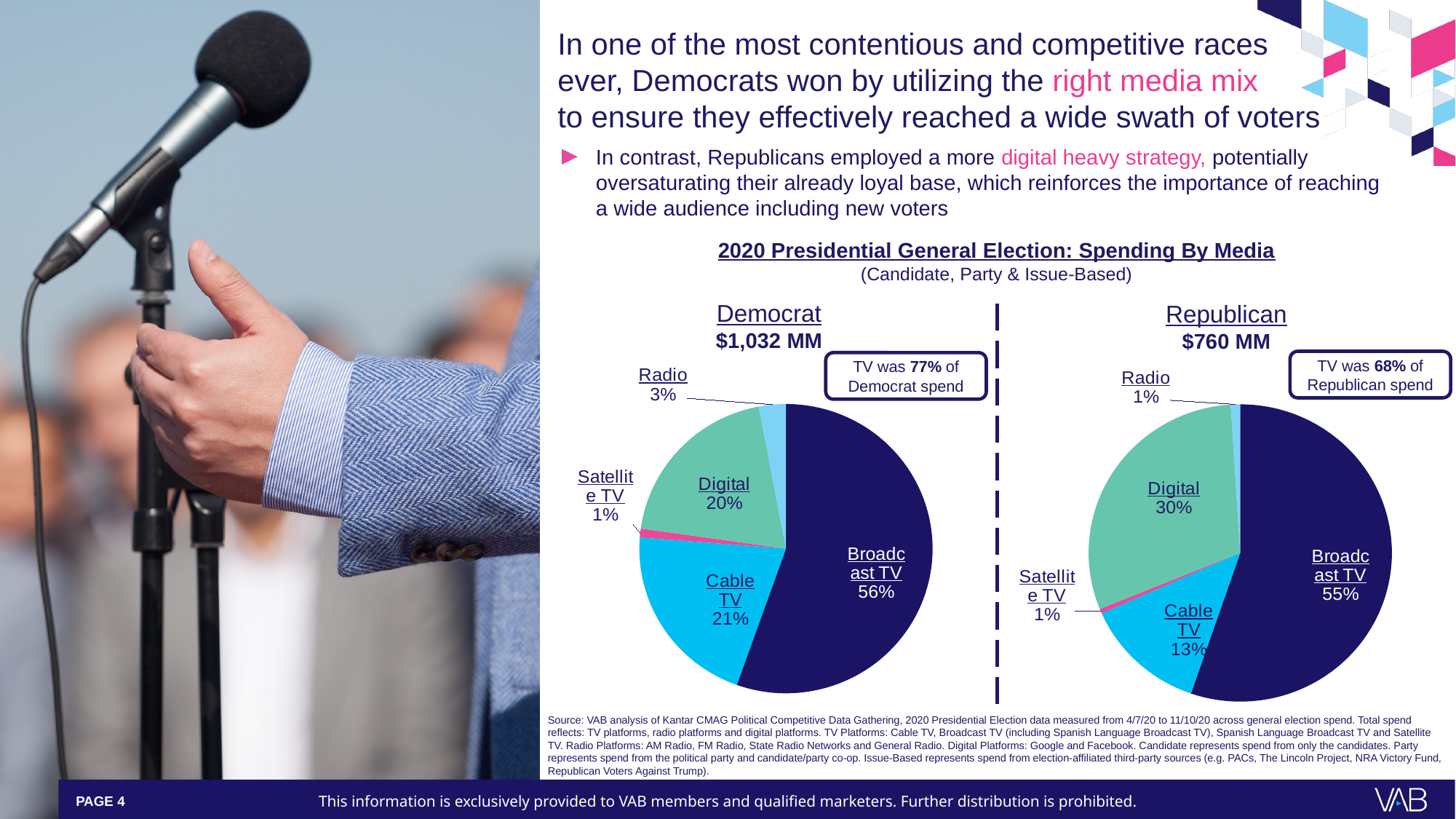
According to the callout on the Republican pie chart, what percentage of Republican spend was TV? 68% What total spend is shown above the Democrat pie chart? $1,032 MM On the Republican pie chart, what share of spending went to Digital? 30% On the Democrat pie chart, which media category has the largest share? Broadcast TV Is the Cable TV share larger on the Democrat pie chart or the Republican pie chart? Democrat On the Republican pie chart, which media category has the smallest share, Cable TV or Digital? Cable TV What type of chart is used to show the Republican spending by media? Pie chart On the Democrat pie chart, what share of spending went to Cable TV? 21% On the Republican pie chart, what share of spending went to Radio? 1% On the Democrat pie chart, what share of spending went to Broadcast TV? 56% How many media categories are shown on the Democrat pie chart? 5 What is the difference between the Digital share on the Republican pie chart and the Digital share on the Democrat pie chart? 10 percentage points